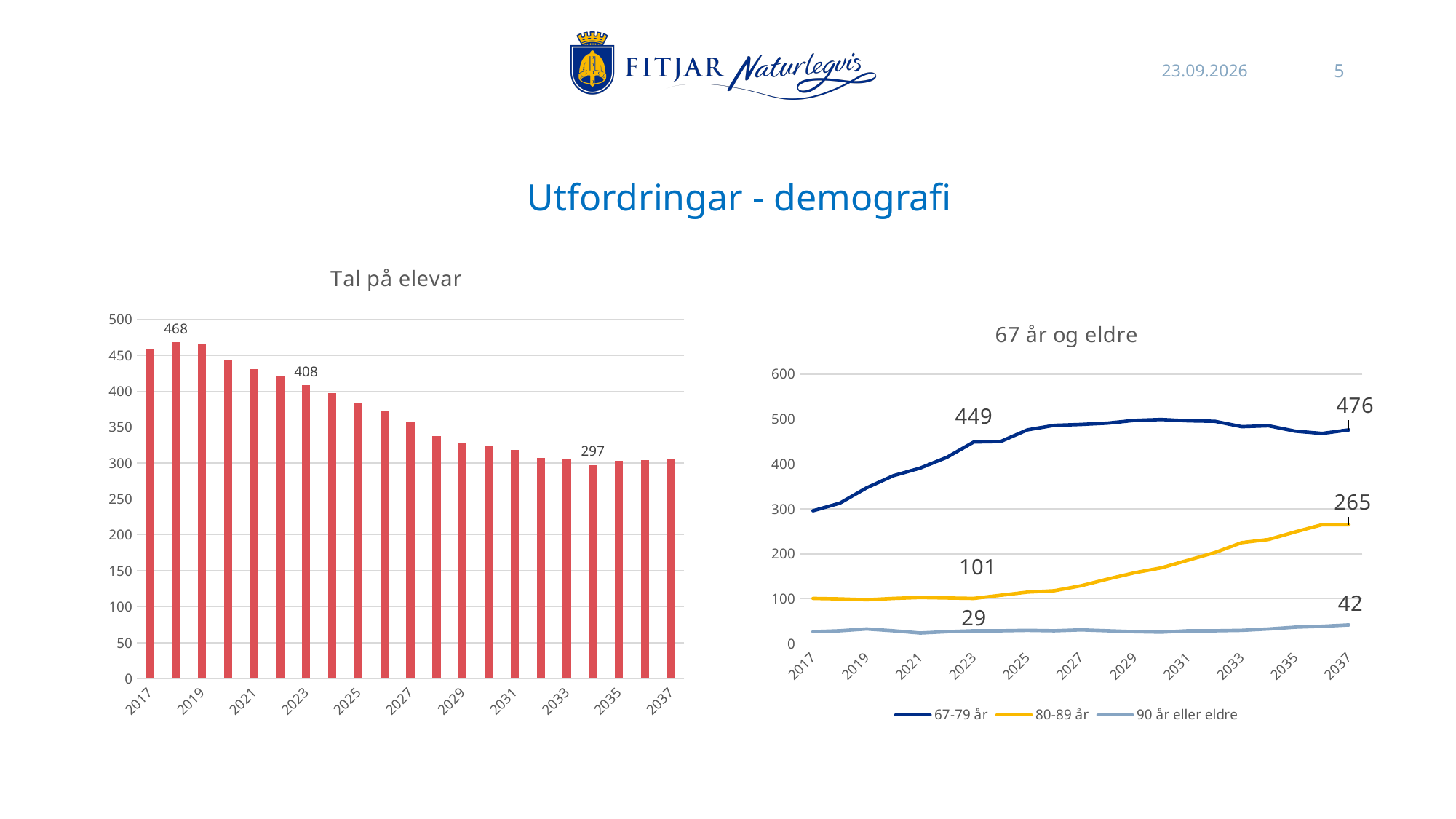
In the 'Tal på elevar' chart, is the value for 2030 greater or less than 350? less In the 'Tal på elevar' chart, what is the value for 2034? 297 In the '67 år og eldre' chart, what is the value for '67-79 år' in 2037? 476 In the 'Tal på elevar' chart, do the values generally rise or fall from 2017 to 2037? fall In the '67 år og eldre' chart, by how much does the '80-89 år' value in 2037 exceed its value in 2023? 164 In the 'Tal på elevar' chart, what is the difference between the 2018 value and the 2034 value? 171 In the '67 år og eldre' chart, which series has the larger value in 2037, '67-79 år' or '90 år eller eldre'? 67-79 år In the 'Tal på elevar' chart, what is the value for 2018? 468 In the 'Tal på elevar' chart, what is the value for 2023? 408 In the '67 år og eldre' chart, what is the value for '80-89 år' in 2023? 101 How many series does the legend of the '67 år og eldre' chart list? 3 What kind of chart is the 'Tal på elevar' chart? bar chart